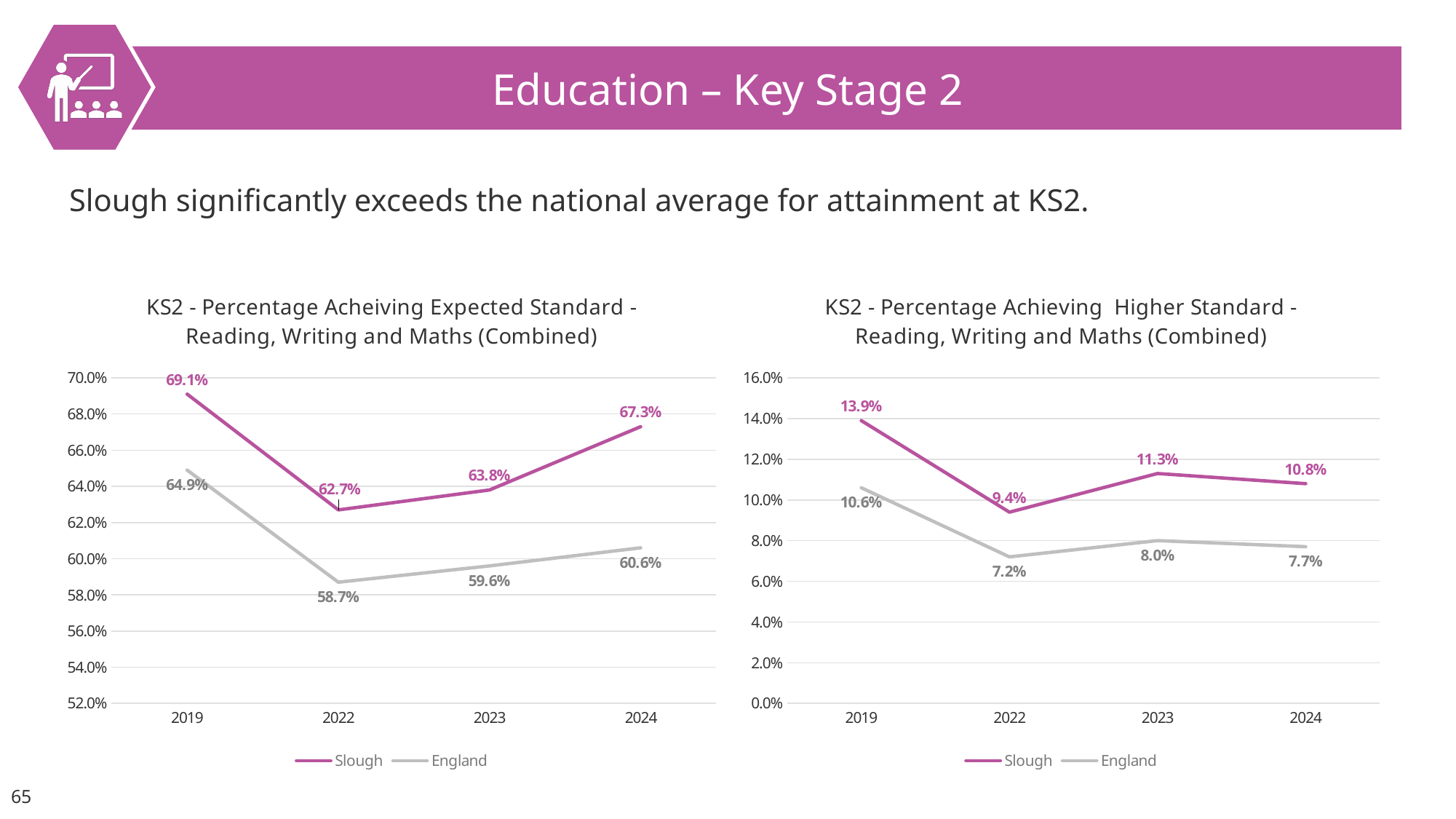
In the left chart (Expected Standard), what was England's value in 2022? 58.7% In the right chart (Higher Standard), which series had the larger value in 2022, Slough or England? Slough How many series does the legend of the right chart (Higher Standard) list? 2 How many years are plotted on the x axis of the left chart (Expected Standard)? 4 In the right chart (Higher Standard), what is the difference between Slough and England in 2019? 3.3% What type of chart is the left chart (Expected Standard)? Line chart In the right chart (Higher Standard), which year had the highest Slough value? 2019 In the left chart (Expected Standard), what was Slough's value in 2019? 69.1% In the left chart (Expected Standard), what is the difference between Slough and England in 2024? 6.7% In the left chart (Expected Standard), which year had the lowest Slough value? 2022 In the right chart (Higher Standard), what was Slough's value in 2023? 11.3% In the right chart (Higher Standard), what was England's value in 2024? 7.7%